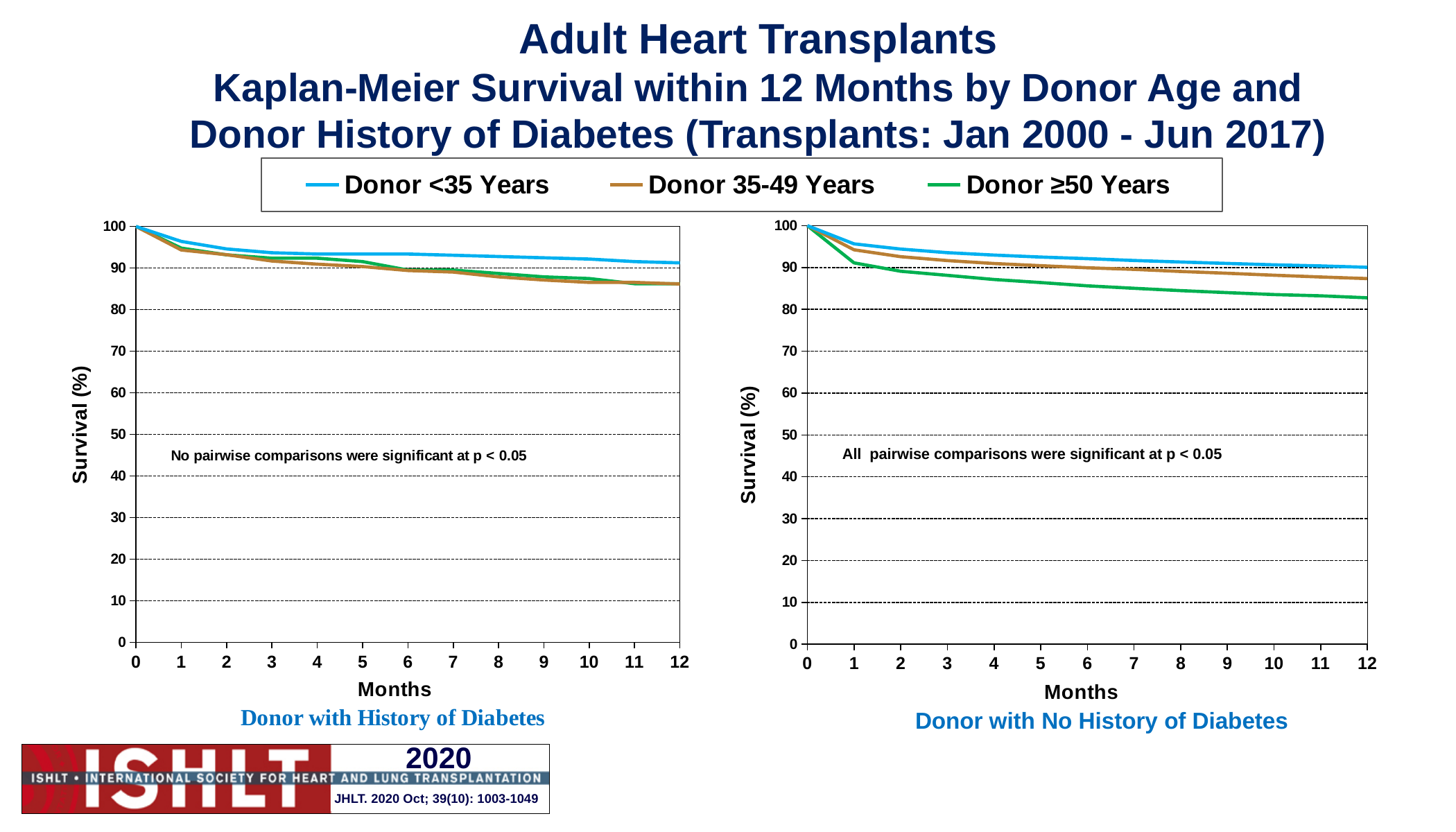
What kind of chart is the 'Donor with History of Diabetes' chart? line chart In the 'Donor with History of Diabetes' chart, is the survival for Donor <35 Years at 12 months greater or less than 90? greater In the 'Donor with No History of Diabetes' chart, is the survival for Donor <35 Years at 12 months greater or less than 80? greater In the 'Donor with No History of Diabetes' chart, is the survival for Donor ≥50 Years at 12 months greater or less than 90? less In the 'Donor with History of Diabetes' chart, do the survival curves rise or fall as months increase? fall In the 'Donor with No History of Diabetes' chart, which donor age group has the lowest survival at 12 months? Donor ≥50 Years What is the label on the y axis of the 'Donor with No History of Diabetes' chart? Survival (%) How many series does the legend list? 3 What annotation is printed inside the 'Donor with No History of Diabetes' chart? All pairwise comparisons were significant at p < 0.05 In the 'Donor with No History of Diabetes' chart, which is larger at 6 months: survival for Donor 35-49 Years or Donor ≥50 Years? Donor 35-49 Years In the 'Donor with No History of Diabetes' chart, which donor age group has the highest survival at 12 months? Donor <35 Years